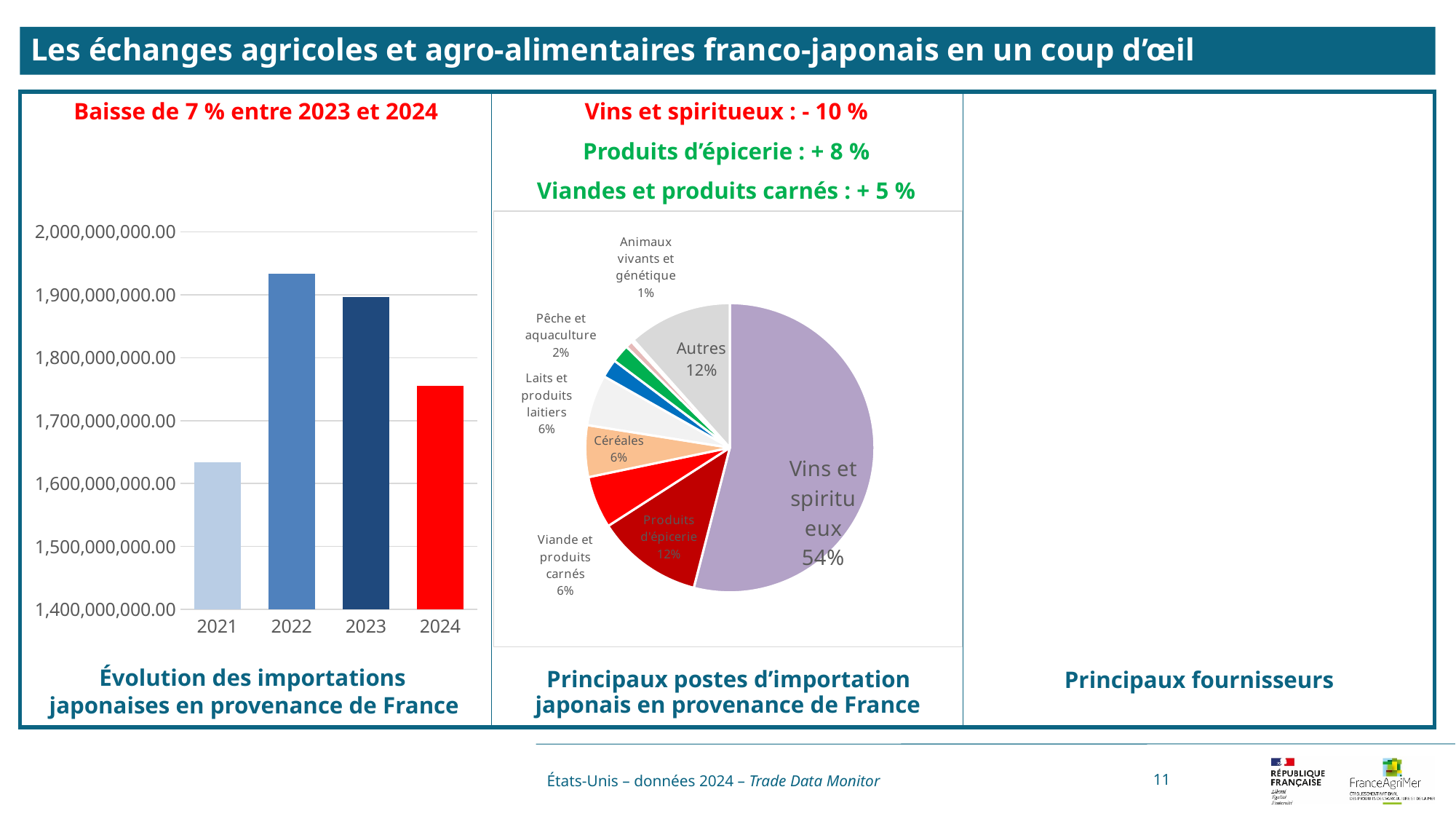
In the bar chart 'Évolution des importations japonaises en provenance de France', is the value for 2022 greater or less than 1,900,000,000.00? greater In the pie chart 'Principaux postes d'importation japonais en provenance de France', what is the difference in percentage points between 'Vins et spiritueux' and 'Produits d'épicerie'? 42 In the pie chart 'Principaux postes d'importation japonais en provenance de France', what share does 'Vins et spiritueux' have? 54% In the bar chart 'Évolution des importations japonaises en provenance de France', is the value for 2024 greater or less than 1,800,000,000.00? less In the bar chart 'Évolution des importations japonaises en provenance de France', is the value for 2021 greater or less than 1,700,000,000.00? less In the pie chart 'Principaux postes d'importation japonais en provenance de France', what is the share of 'Pêche et aquaculture'? 2% In the bar chart 'Évolution des importations japonaises en provenance de France', which year has the lowest value? 2021 In the bar chart 'Évolution des importations japonaises en provenance de France', which year has the highest value? 2022 In the bar chart 'Évolution des importations japonaises en provenance de France', which is larger, the value for 2023 or the value for 2024? 2023 How many years are shown in the bar chart 'Évolution des importations japonaises en provenance de France'? 4 What kind of chart is 'Principaux postes d'importation japonais en provenance de France'? pie chart